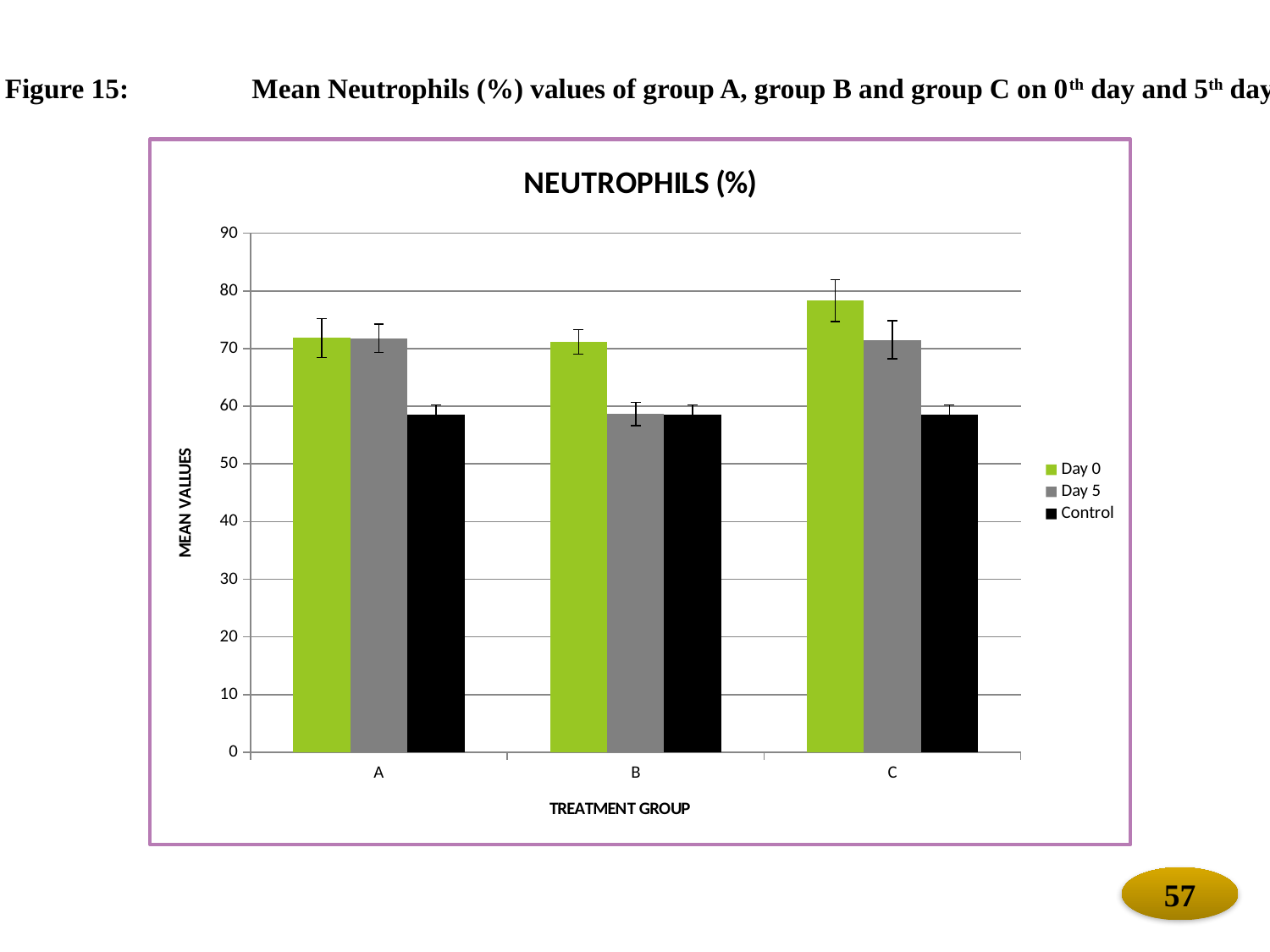
What type of chart is shown on the slide? Bar chart Is the Day 0 value for group C greater or less than 70? greater Which series has the lowest value for treatment group A? Control What is the title of the chart? NEUTROPHILS (%) How many treatment groups are shown on the x axis? 3 Is the Day 0 value for group C larger or smaller than the Day 0 value for group A? Larger How many series does the legend list? 3 Which series has the lowest value for treatment group C? Control Which series has the highest value for treatment group B? Day 0 Is the Control value for group A greater or less than 70? less Is the Day 5 value for group B larger or smaller than the Day 5 value for group A? Smaller Which series has the highest value for treatment group C? Day 0